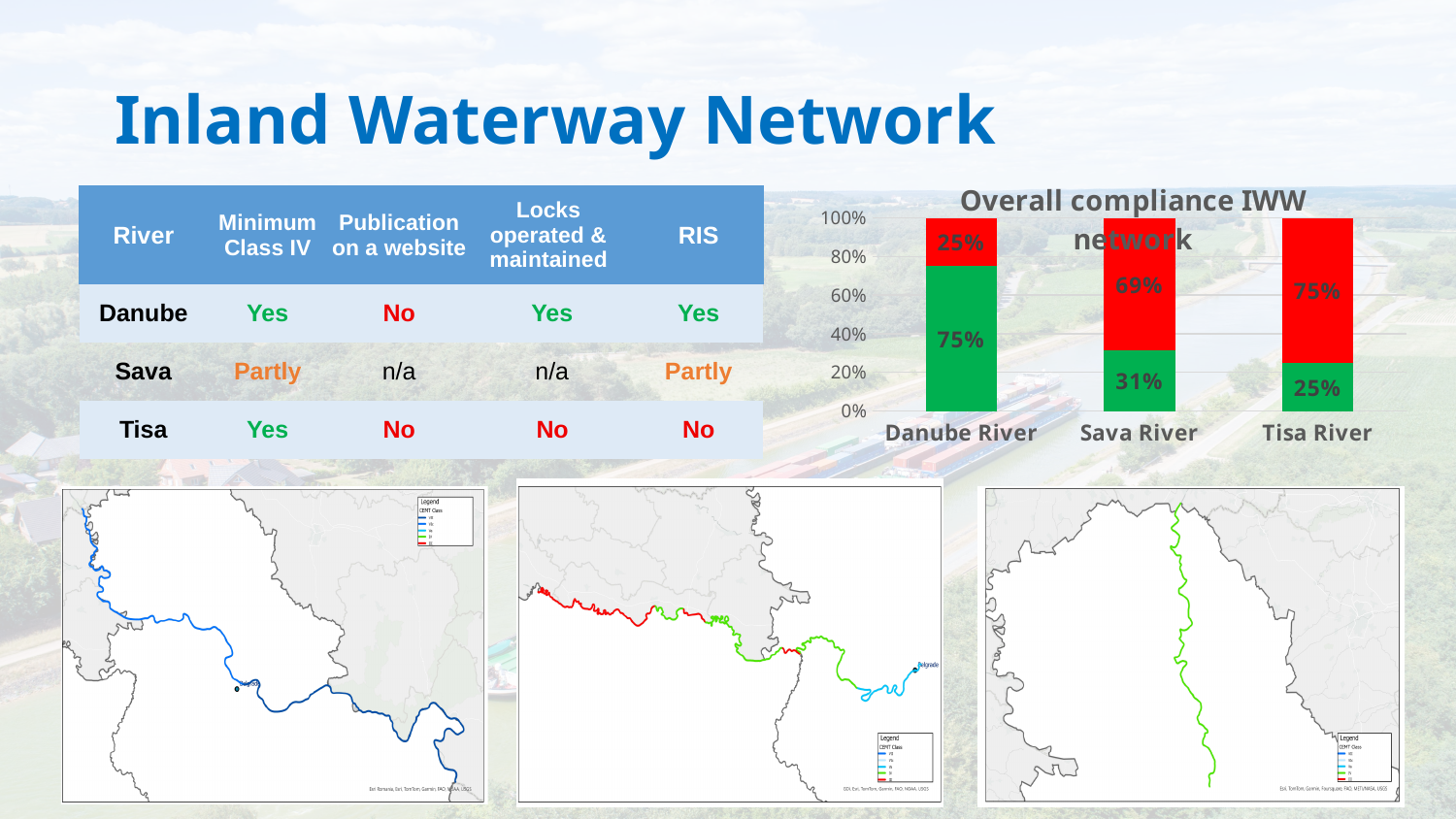
What is the total of the stacked bar for Sava River in the Overall compliance IWW network chart? 100% What is the value of the red segment for Danube River in the Overall compliance IWW network chart? 25% Which river has the smallest green segment in the Overall compliance IWW network chart? Tisa River What kind of chart is the Overall compliance IWW network chart? Stacked bar chart How many rivers are shown on the x axis of the Overall compliance IWW network chart? 3 What is the title of the chart on the slide? Overall compliance IWW network What is the value of the green segment for Tisa River in the Overall compliance IWW network chart? 25% What is the value of the green segment for Danube River in the Overall compliance IWW network chart? 75% Is the red segment larger for Sava River or for Tisa River in the Overall compliance IWW network chart? Tisa River What is the difference between the green segment values for Danube River and Sava River in the Overall compliance IWW network chart? 44% What is the value of the red segment for Sava River in the Overall compliance IWW network chart? 69% Which river has the largest green segment in the Overall compliance IWW network chart? Danube River